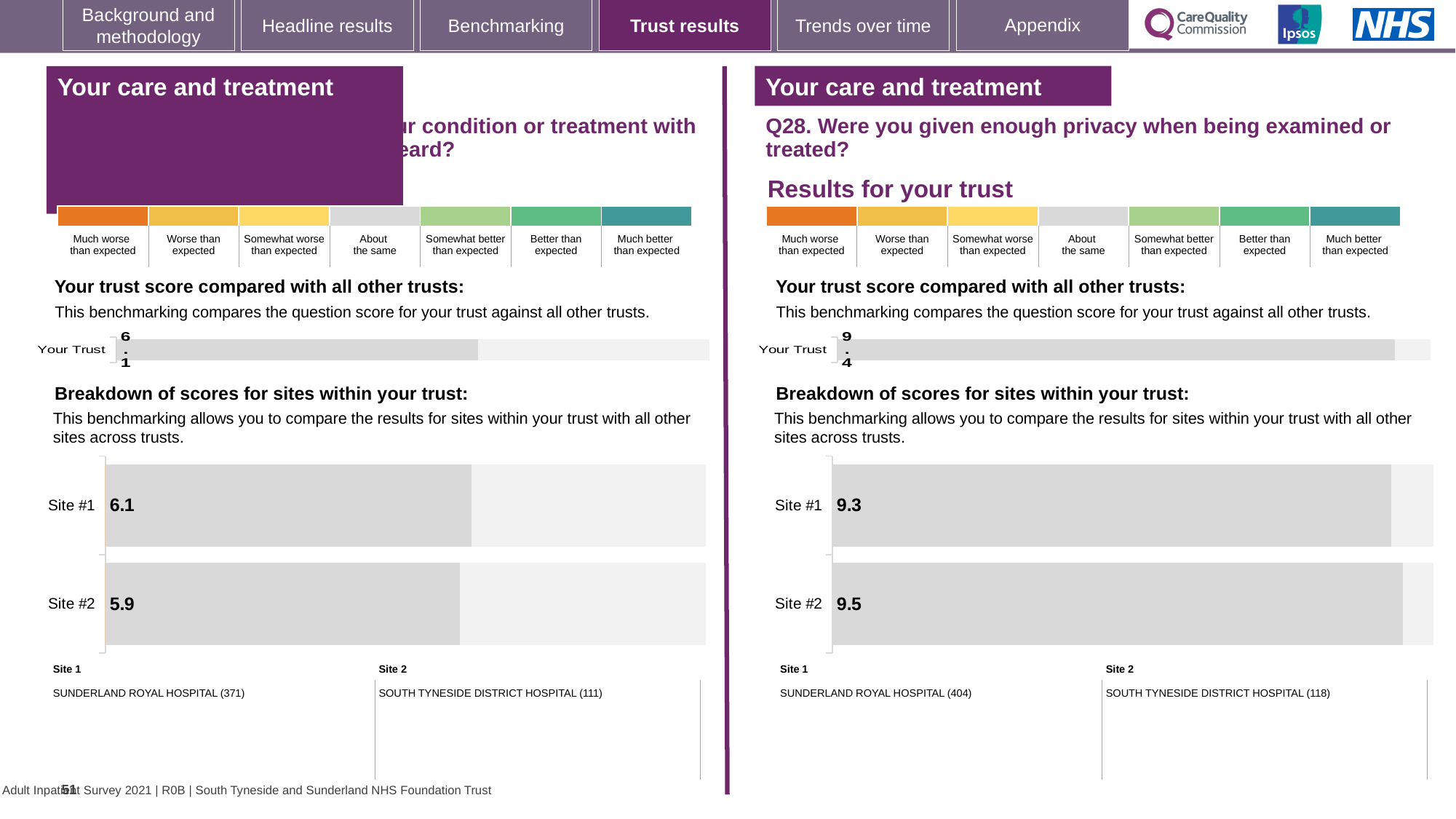
What type of chart is used to show the breakdown of scores for sites within the trust? Bar chart On the right-hand chart for Q28, which site has the lower score? Site #1 On the left-hand chart, which site has the higher score, Site #1 or Site #2? Site #1 On the left-hand chart, what is the score for Site #2? 5.9 On the right-hand panel for Q28, which hospital is listed as Site 2? SOUTH TYNESIDE DISTRICT HOSPITAL (118) On the left-hand chart, what is the difference between the Site #1 score and the Site #2 score? 0.2 On the right-hand chart for Q28, what is the score for Site #2? 9.5 On the right-hand chart for Q28 (privacy when being examined or treated), what is the score for Your Trust? 9.4 On the right-hand chart for Q28, what is the score for Site #1? 9.3 On the left-hand chart, what is the score for Your Trust? 6.1 How many sites are shown in the site breakdown chart on the right-hand side for Q28? 2 On the right-hand chart for Q28, what is the difference between the Site #2 score and the Site #1 score? 0.2